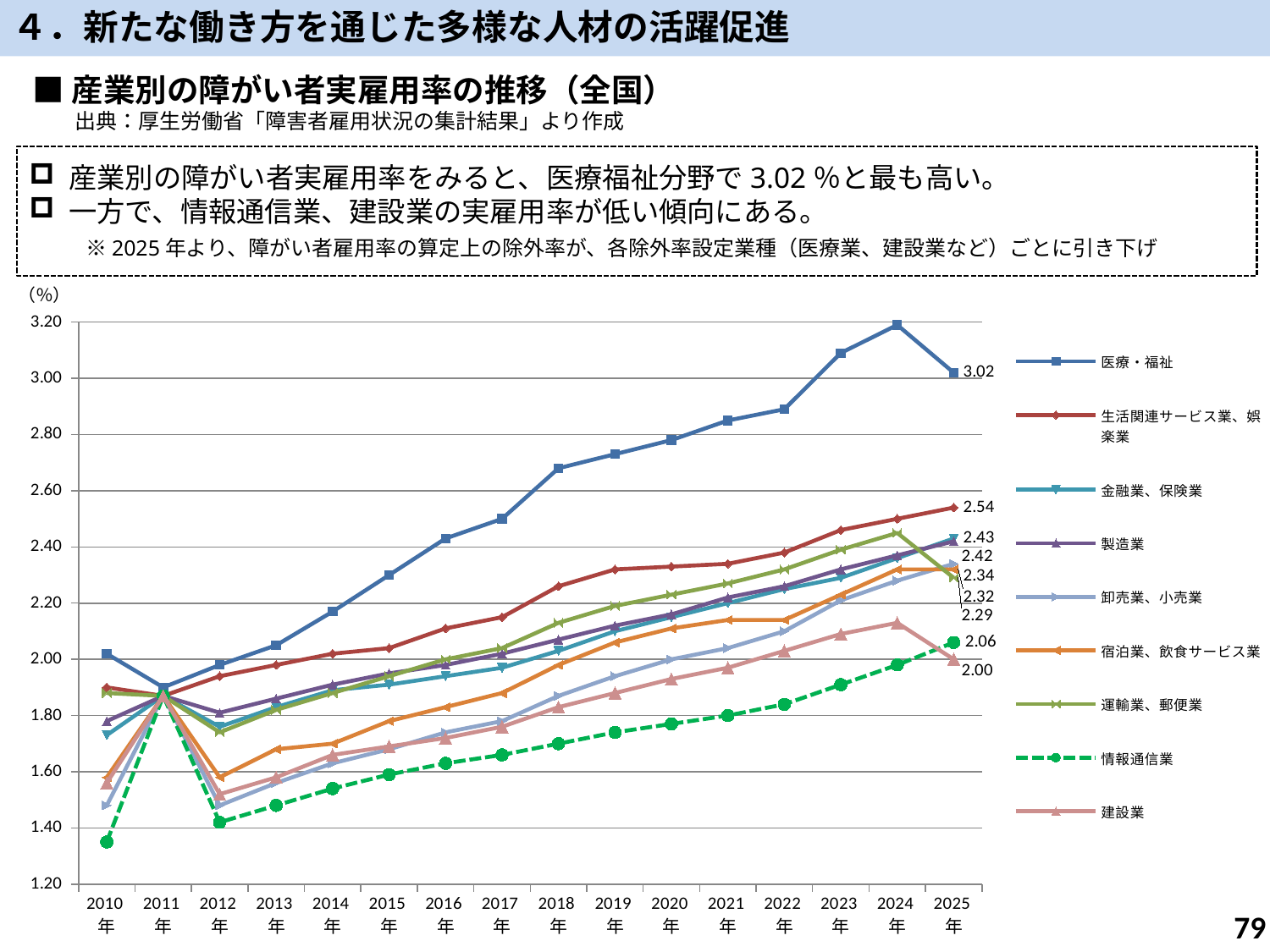
Is the value for 医療・福祉 in 2024年 greater or less than 3.00? greater Which series has the lowest value in 2025年? 建設業 How many years are plotted along the x axis? 16 What is the value for 情報通信業 in 2025年? 2.06 What is the value for 生活関連サービス業、娯楽業 in 2025年? 2.54 Which series has the highest value in 2025年? 医療・福祉 What is the difference between 医療・福祉 and 建設業 in 2025年? 1.02 What kind of chart is shown on the slide? line chart What is the value for 建設業 in 2025年? 2.00 Which series is drawn with a dashed line? 情報通信業 What is the value for 医療・福祉 in 2025年? 3.02 How many series does the legend list? 9